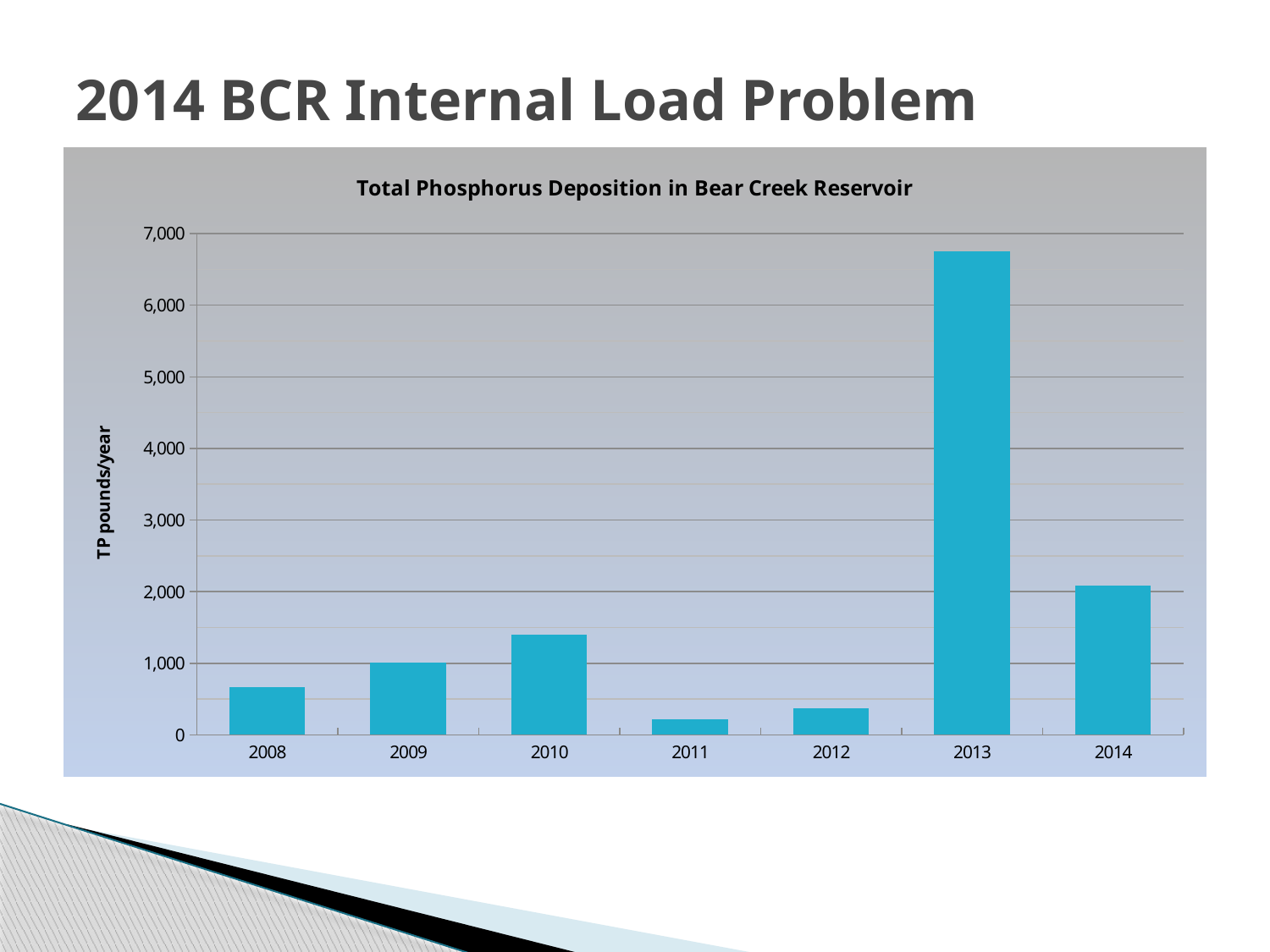
Is the value for 2010 greater or less than 1,000? greater Is the value for 2011 greater or less than 1,000? less Is the value for 2014 greater or less than 3,000? less Which year has the highest total phosphorus deposition? 2013 Which year has a larger value, 2010 or 2009? 2010 How many years are shown on the x axis of the chart? 7 Which year has the lowest total phosphorus deposition? 2011 What type of chart is shown on the slide? Bar chart Do the values rise or fall from 2008 to 2010? rise What is the title of the chart? Total Phosphorus Deposition in Bear Creek Reservoir What is the label on the vertical axis of the chart? TP pounds/year